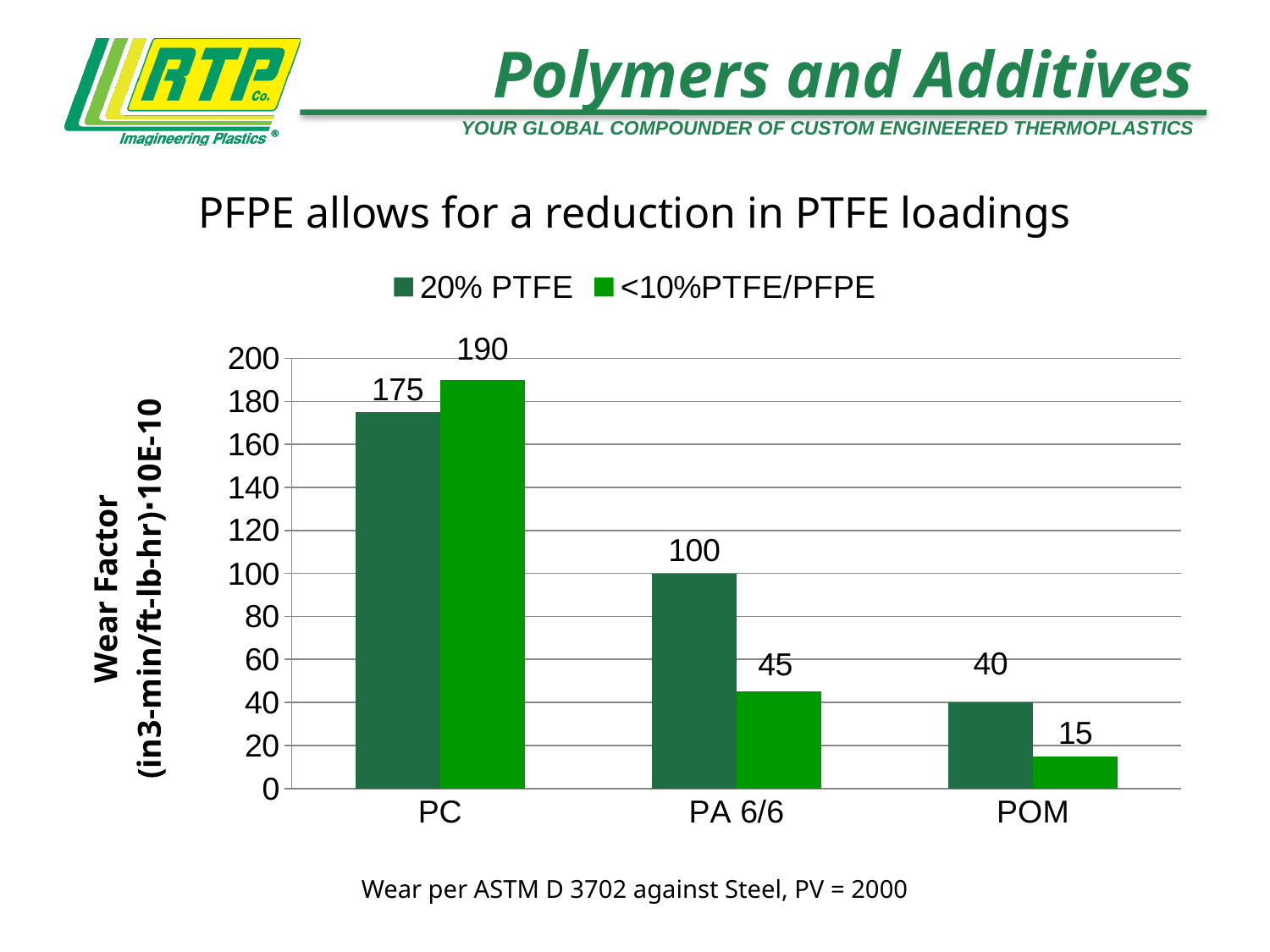
Which material has the highest wear factor in the <10%PTFE/PFPE series? PC How many series does the legend list? 2 How many materials are shown on the x axis? 3 Is the wear factor for POM with <10%PTFE/PFPE greater or less than 20? less Which material has the lowest wear factor in the 20% PTFE series? POM What kind of chart is shown on the slide? bar chart What is the difference between the 20% PTFE and <10%PTFE/PFPE wear factors for PA 6/6? 55 For PC, which is larger: the 20% PTFE value or the <10%PTFE/PFPE value? <10%PTFE/PFPE What is the wear factor for POM with 20% PTFE? 40 What is the y-axis label of the chart? Wear Factor (in3-min/ft-lb-hr)·10E-10 What is the wear factor for PA 6/6 with <10%PTFE/PFPE? 45 What is the wear factor for PC with 20% PTFE? 175